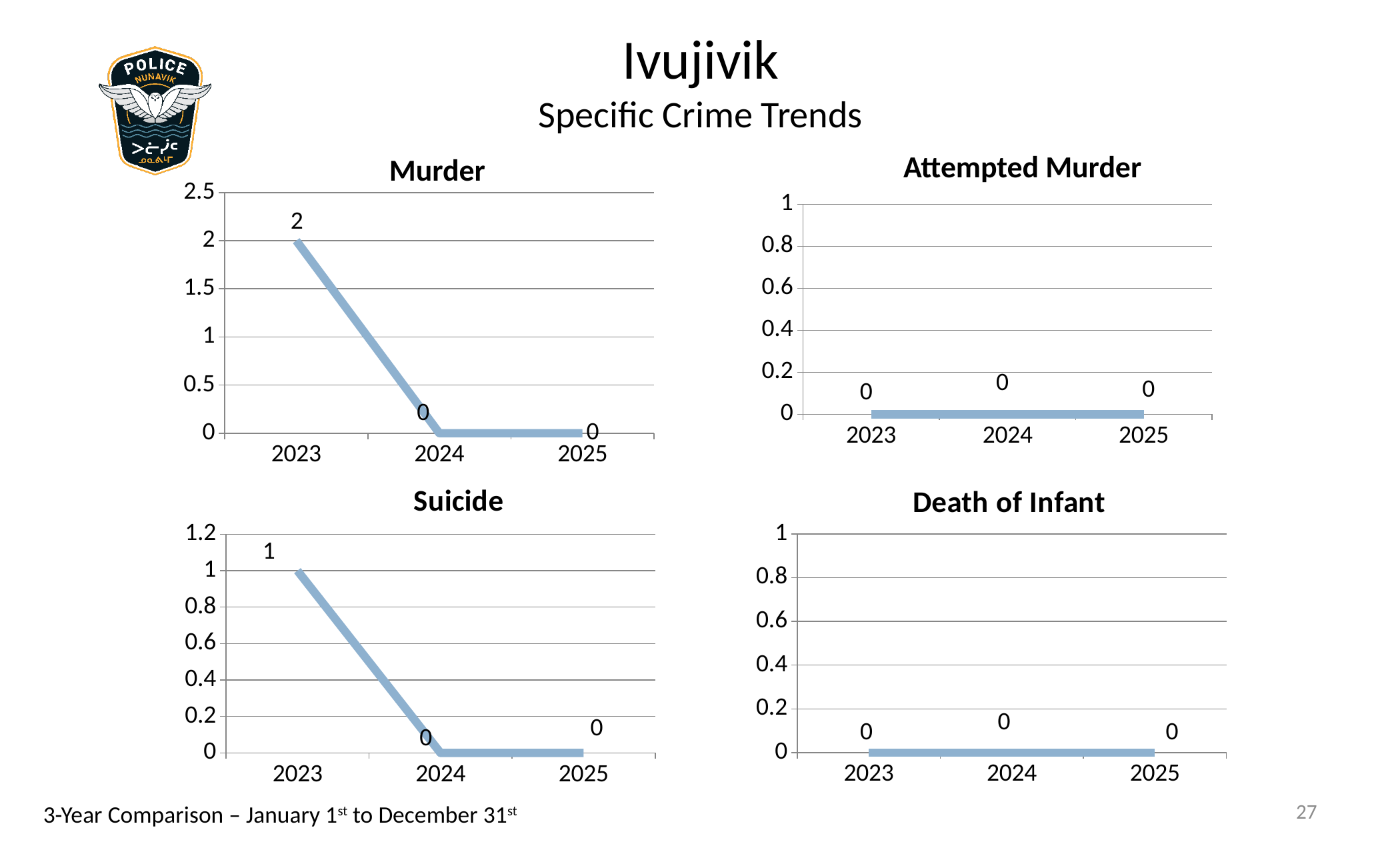
In the Murder chart, what is the difference between the 2023 and 2024 values? 2 In the Death of Infant chart, what is the value for 2024? 0 What kind of chart is the Suicide chart? line chart In the Murder chart, which year has the highest value? 2023 In the Murder chart, what is the value for 2024? 0 In the Suicide chart, what is the value for 2023? 1 In the Attempted Murder chart, what is the value for 2025? 0 In the Murder chart, what is the value for 2023? 2 In the Suicide chart, which year has the highest value? 2023 In the Suicide chart, which is larger, the value for 2023 or the value for 2025? 2023 How many years are plotted in the Murder chart? 3 In the Murder chart, do the values rise or fall from 2023 to 2025? fall